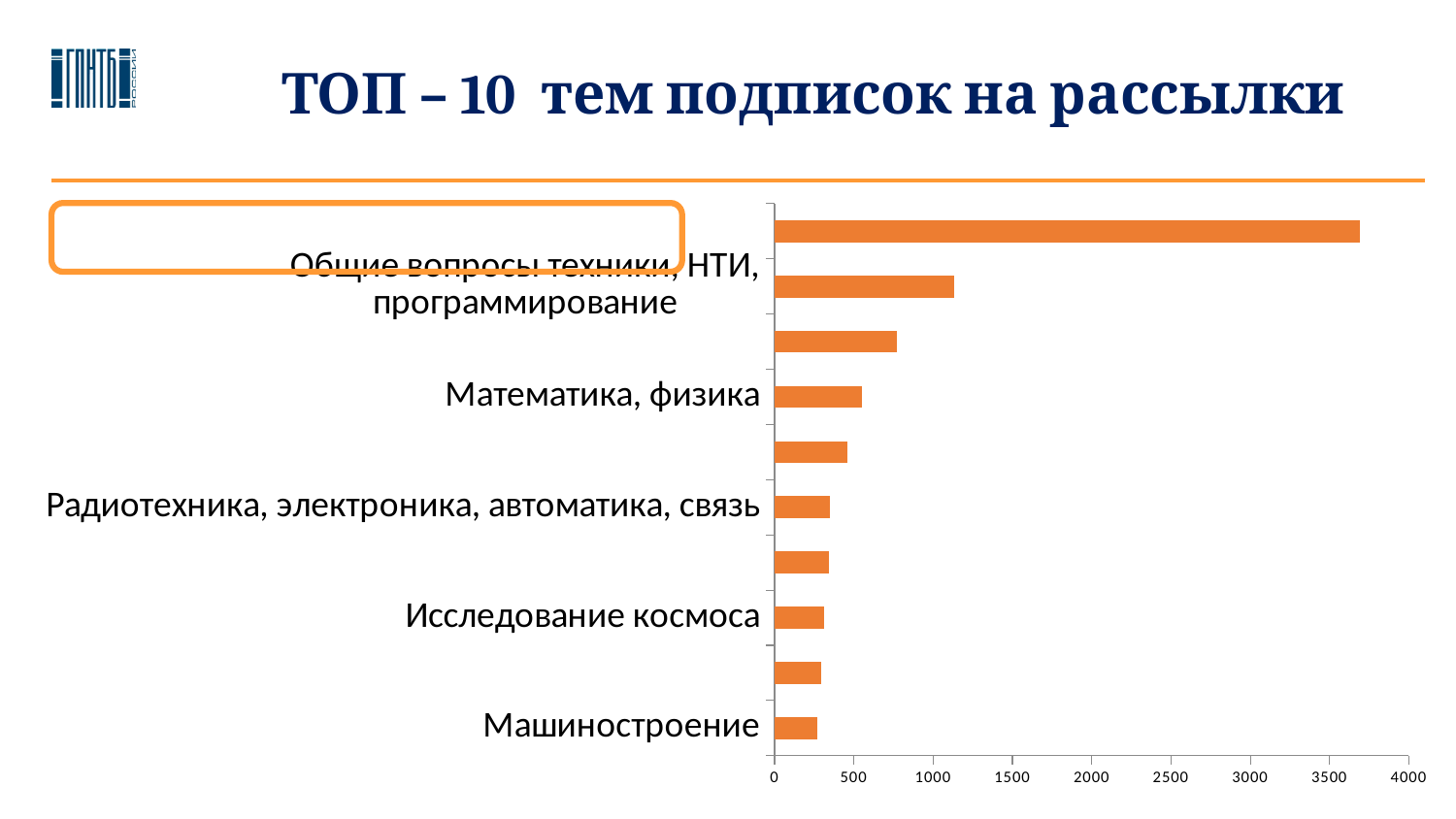
Is the value for Общие вопросы техники, НТИ, программирование greater or less than 1500? less Is the value for Исследование космоса greater or less than 500? less Which has a larger value: Общие вопросы техники, НТИ, программирование or Математика, физика? Общие вопросы техники, НТИ, программирование How many bars does the chart contain? 10 Is the value for Машиностроение greater or less than 500? less What kind of chart is shown on the slide? bar chart Which has a larger value: Математика, физика or Машиностроение? Математика, физика What is the title of the slide? ТОП – 10 тем подписок на рассылки Do the bar values increase or decrease going from the top bar to the bottom bar? decrease